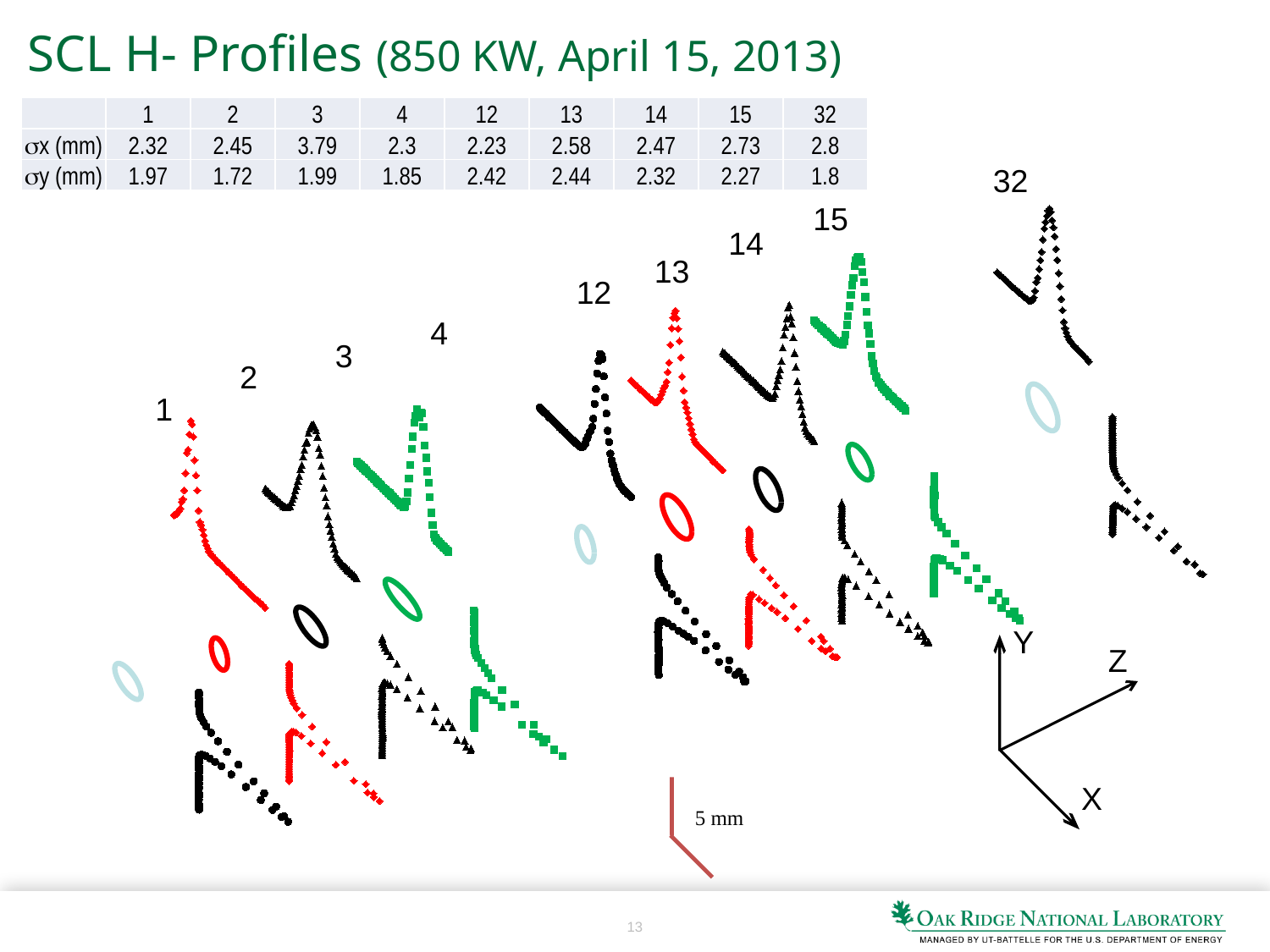
Which station has the smallest σy value in the table? 2 Which station has the largest σx value in the table? 3 How many stations (profile locations) are listed in the table and plotted? 9 Which is larger, the σy value for station 13 or for station 32? station 13 What kind of chart is the profile plot on the slide? scatter plot What is the difference between the σx values of station 3 and station 12? 1.56 What are the three axes labelled in the profile plot? X, Y, Z Which station has the largest σy value in the table? 13 What is the σy value for station 12 in the table? 2.42 What length does the scale bar in the profile plot represent? 5 mm Which station has the smallest σx value in the table? 12 What is the σx value for station 3 in the table? 3.79